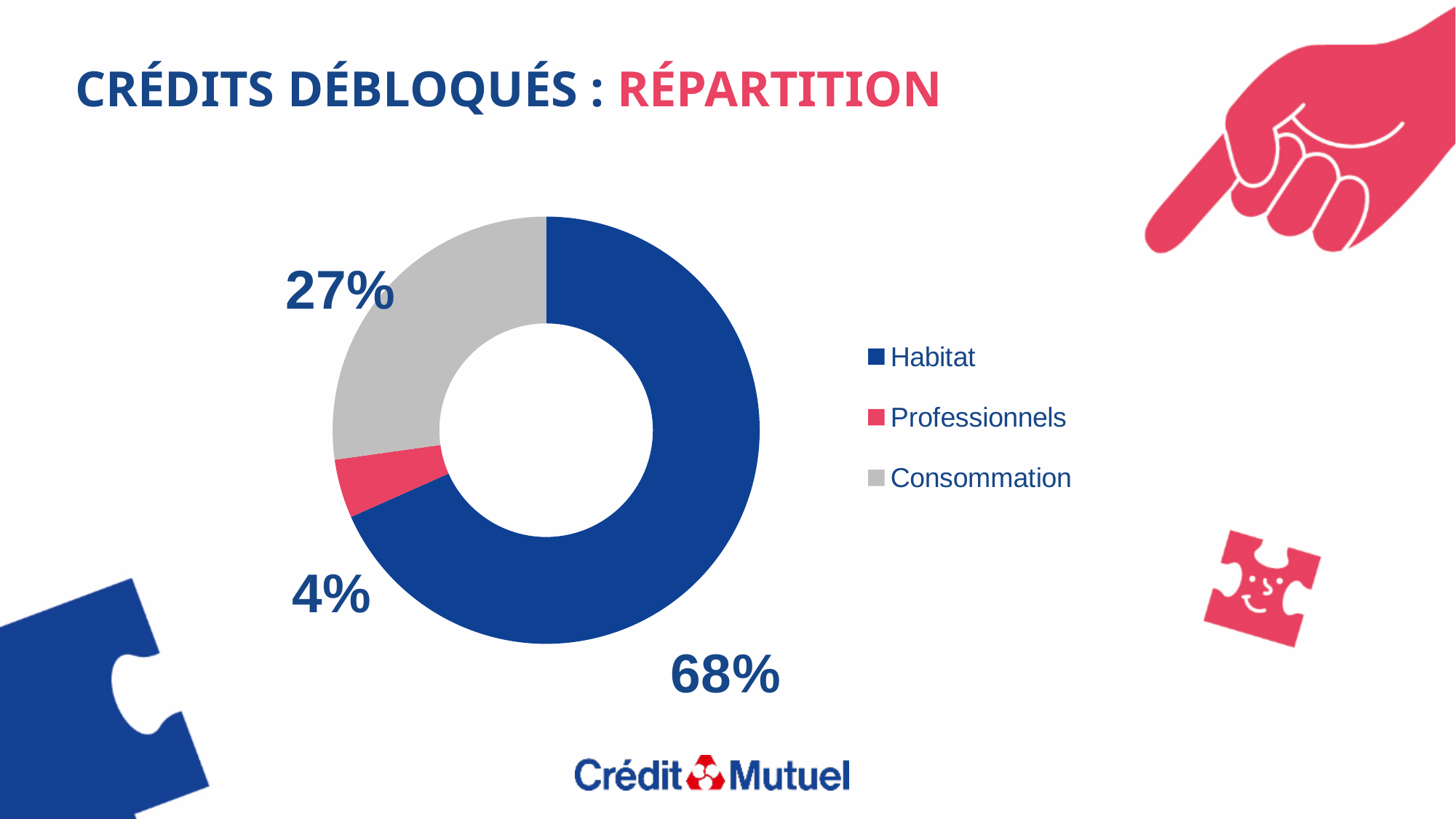
What share of the chart does Professionnels represent? 4% What kind of chart is shown on the slide? Doughnut chart What share of the chart does Habitat represent? 68% What is the title of the slide? CRÉDITS DÉBLOQUÉS : RÉPARTITION What share of the chart does Consommation represent? 27% What colour is the Consommation segment? Grey What is the difference in percentage points between Consommation and Professionnels? 23 How many categories does the chart show? 3 Which category has the smallest share? Professionnels Which is larger, the share for Consommation or the share for Professionnels? Consommation What is the difference in percentage points between Habitat and Consommation? 41 Which category has the largest share? Habitat